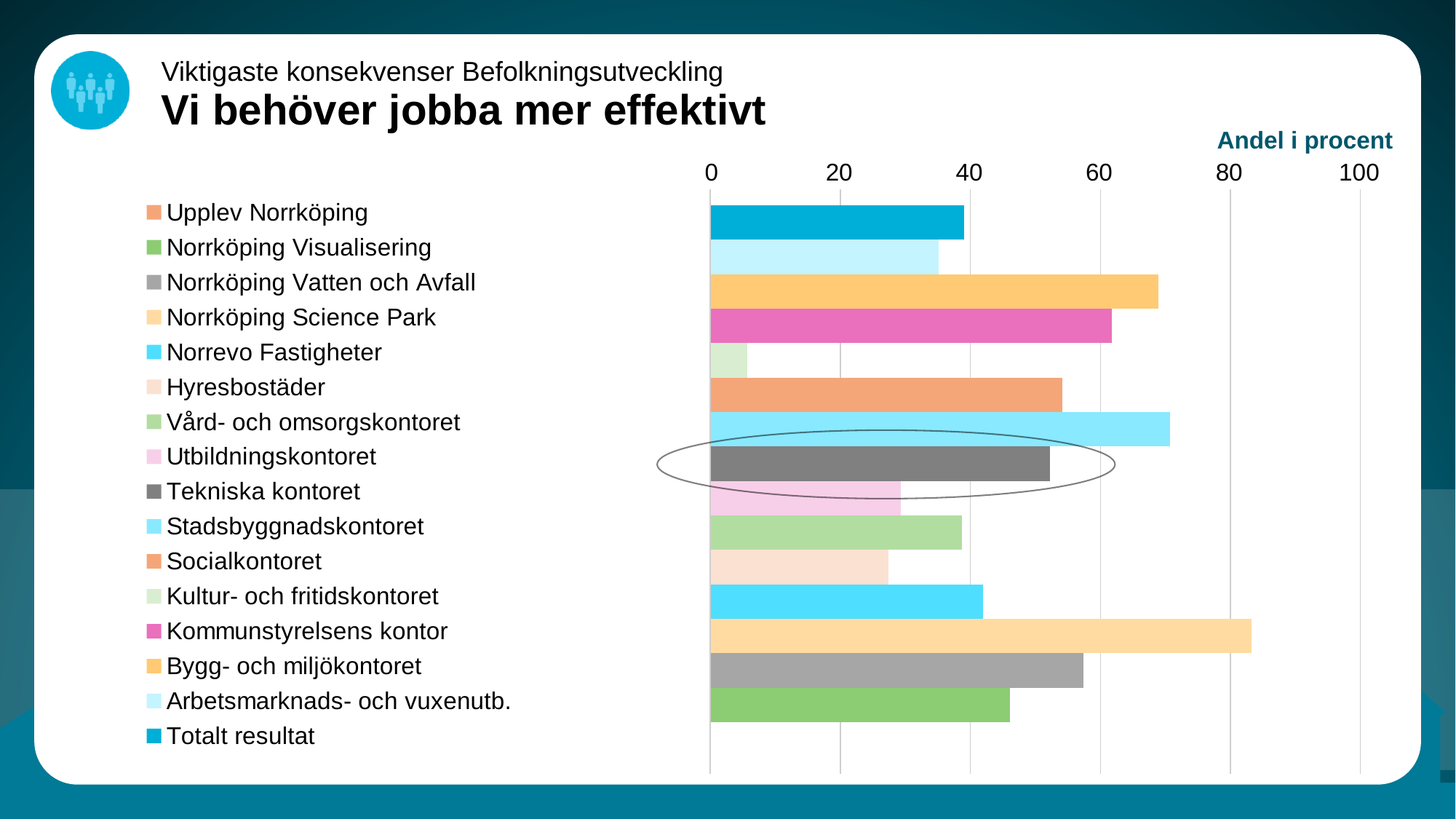
Which has the larger value, Stadsbyggnadskontoret or Socialkontoret? Stadsbyggnadskontoret Is the value for Utbildningskontoret greater or less than 40? less How many entries does the legend list? 16 Is the value for Bygg- och miljökontoret greater or less than 60? greater Which has the larger value, Bygg- och miljökontoret or Kommunstyrelsens kontor? Bygg- och miljökontoret Is the value for Kultur- och fritidskontoret greater or less than 20? less Which entry's bar is highlighted with an ellipse on the chart? Tekniska kontoret What is the label shown above the horizontal axis of the chart? Andel i procent What kind of chart is shown on the slide? bar chart Which entry has the highest value in the chart? Norrköping Science Park